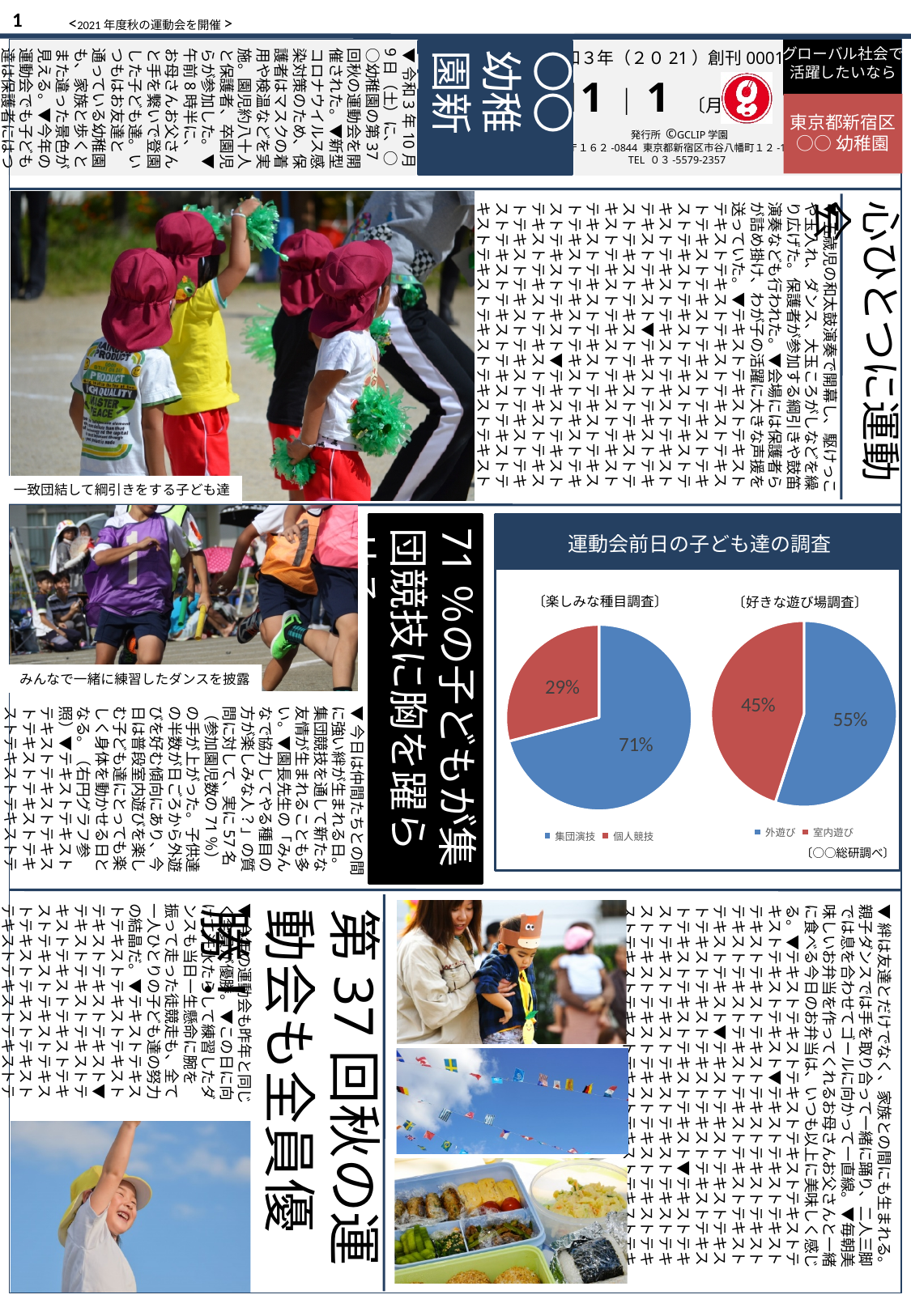
In the 〔好きな遊び場調査〕 pie chart, what is the difference in percentage points between 外遊び and 室内遊び? 10 What is the title shown above the two pie charts? 運動会前日の子ども達の調査 In the 〔楽しみな種目調査〕 pie chart, what share is shown for 集団演技? 71% In the 〔好きな遊び場調査〕 pie chart, which is larger, 外遊び or 室内遊び? 外遊び In the 〔好きな遊び場調査〕 pie chart, what share is shown for 外遊び? 55% In the 〔好きな遊び場調査〕 pie chart, what share is shown for 室内遊び? 45% What type of chart is used in the 〔楽しみな種目調査〕 chart? Pie chart How many slices does the 〔好きな遊び場調査〕 pie chart have? 2 In the 〔楽しみな種目調査〕 pie chart, what share is shown for 個人競技? 29% In the 〔楽しみな種目調査〕 pie chart, which category has the largest share? 集団演技 In the 〔楽しみな種目調査〕 pie chart, what is the difference in percentage points between 集団演技 and 個人競技? 42 In the 〔好きな遊び場調査〕 pie chart, which category has the smallest share? 室内遊び